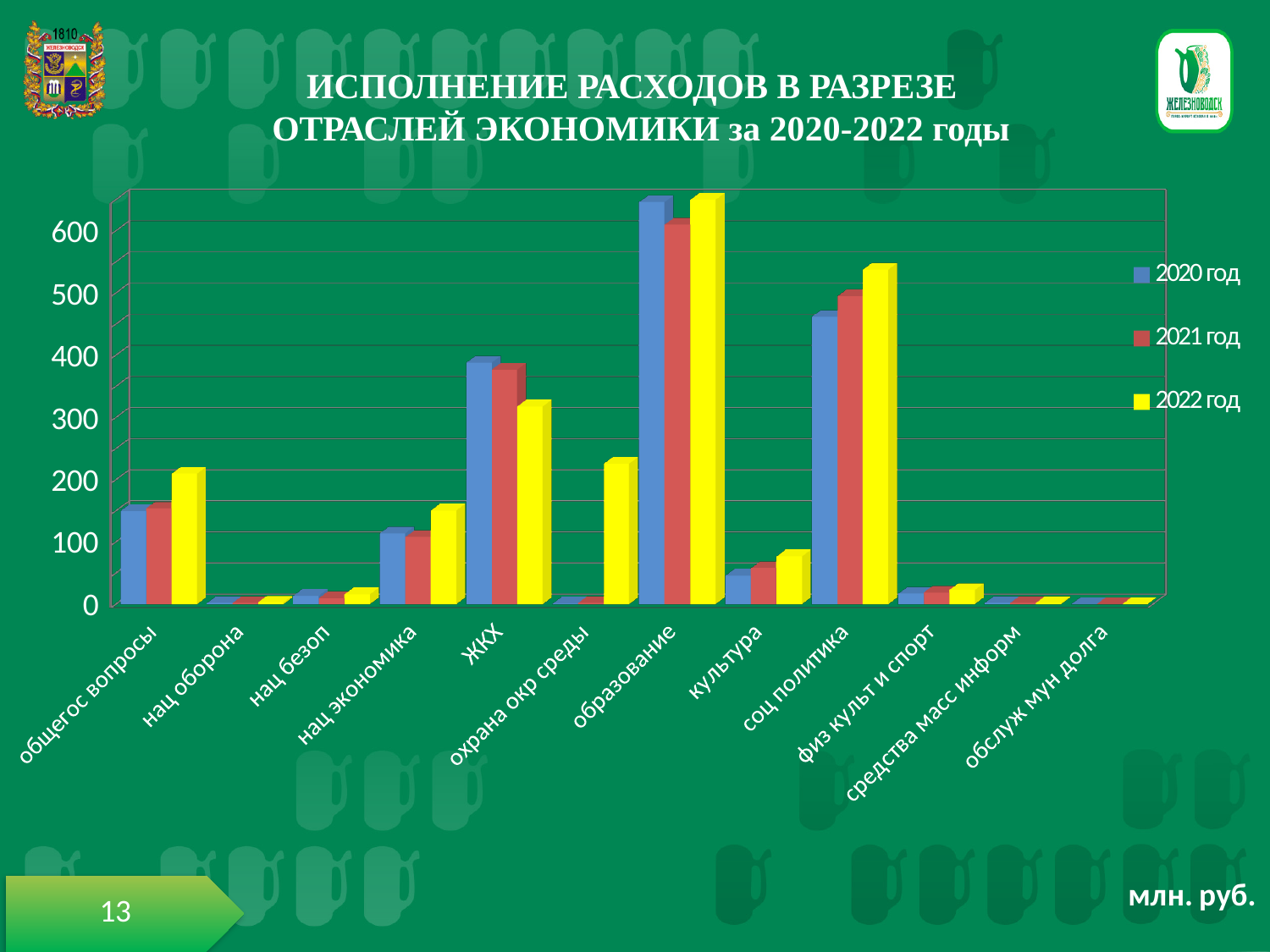
Is the value for соц политика in 2022 год greater or less than 500? greater For соц политика, which year has the larger value: 2020 год or 2022 год? 2022 год Is the value for культура in 2022 год greater or less than 100? less Which category has the highest values across all three years? образование Is the value for ЖКХ in 2020 год greater or less than 300? greater What unit is indicated for the values on the slide? млн. руб. For ЖКХ, which year has the larger value: 2020 год or 2022 год? 2020 год What kind of chart is shown on the slide? bar chart How many series does the legend list? 3 How many categories are shown on the x axis? 12